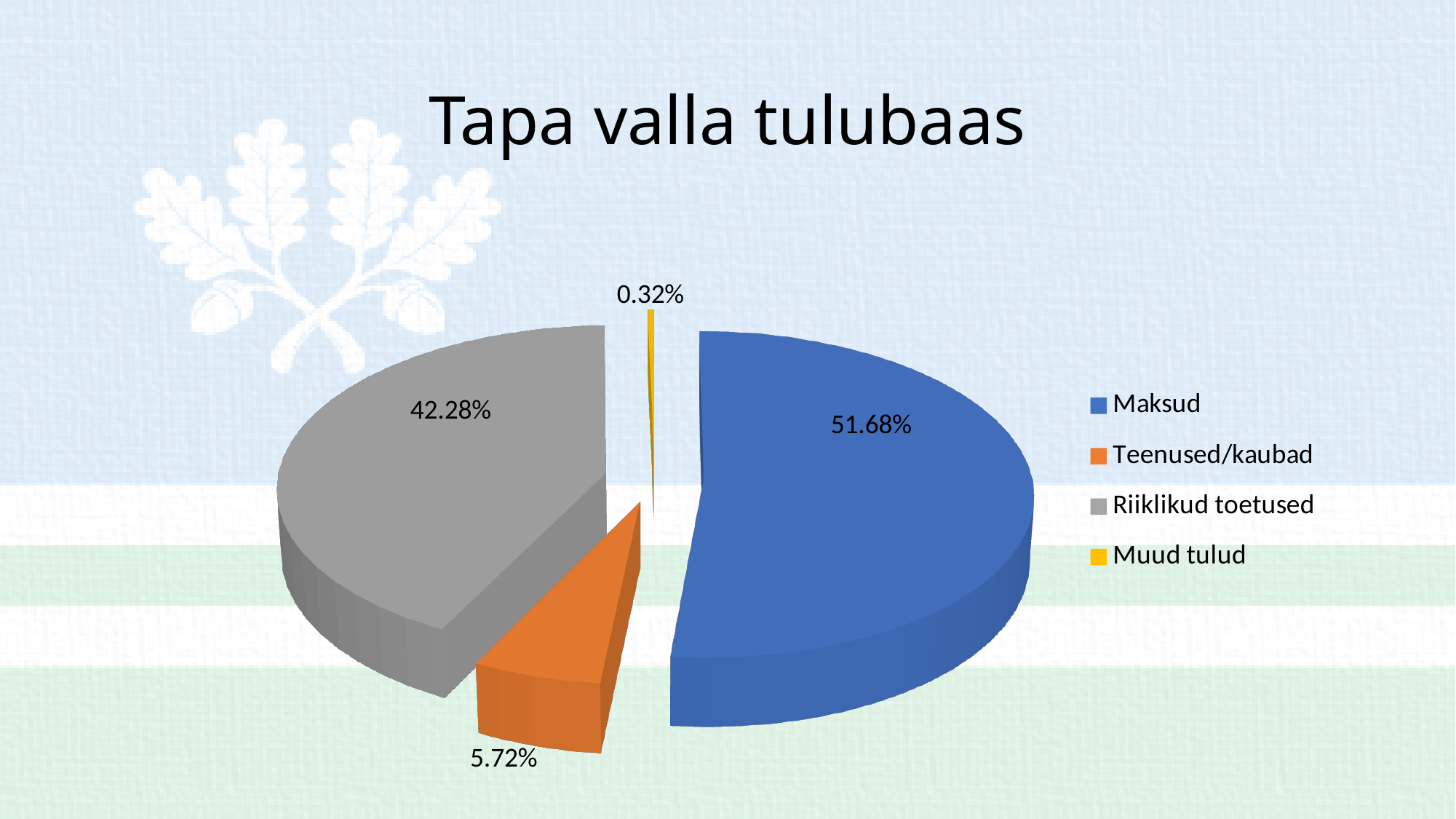
Which is larger, the share for Teenused/kaubad or the share for Muud tulud? Teenused/kaubad What share of the pie does Riiklikud toetused represent? 42.28% What share of the pie does Teenused/kaubad represent? 5.72% What kind of chart is shown on the slide? Pie chart Which category has the largest share of the pie? Maksud How many categories are shown in the pie chart? 4 What share of the pie does Maksud represent? 51.68% What share of the pie does Muud tulud represent? 0.32% Which category has the smallest share of the pie? Muud tulud What is the difference in percentage points between Maksud and Riiklikud toetused? 9.40 Which colour represents Riiklikud toetused in the legend? Grey What is the title of the chart? Tapa valla tulubaas